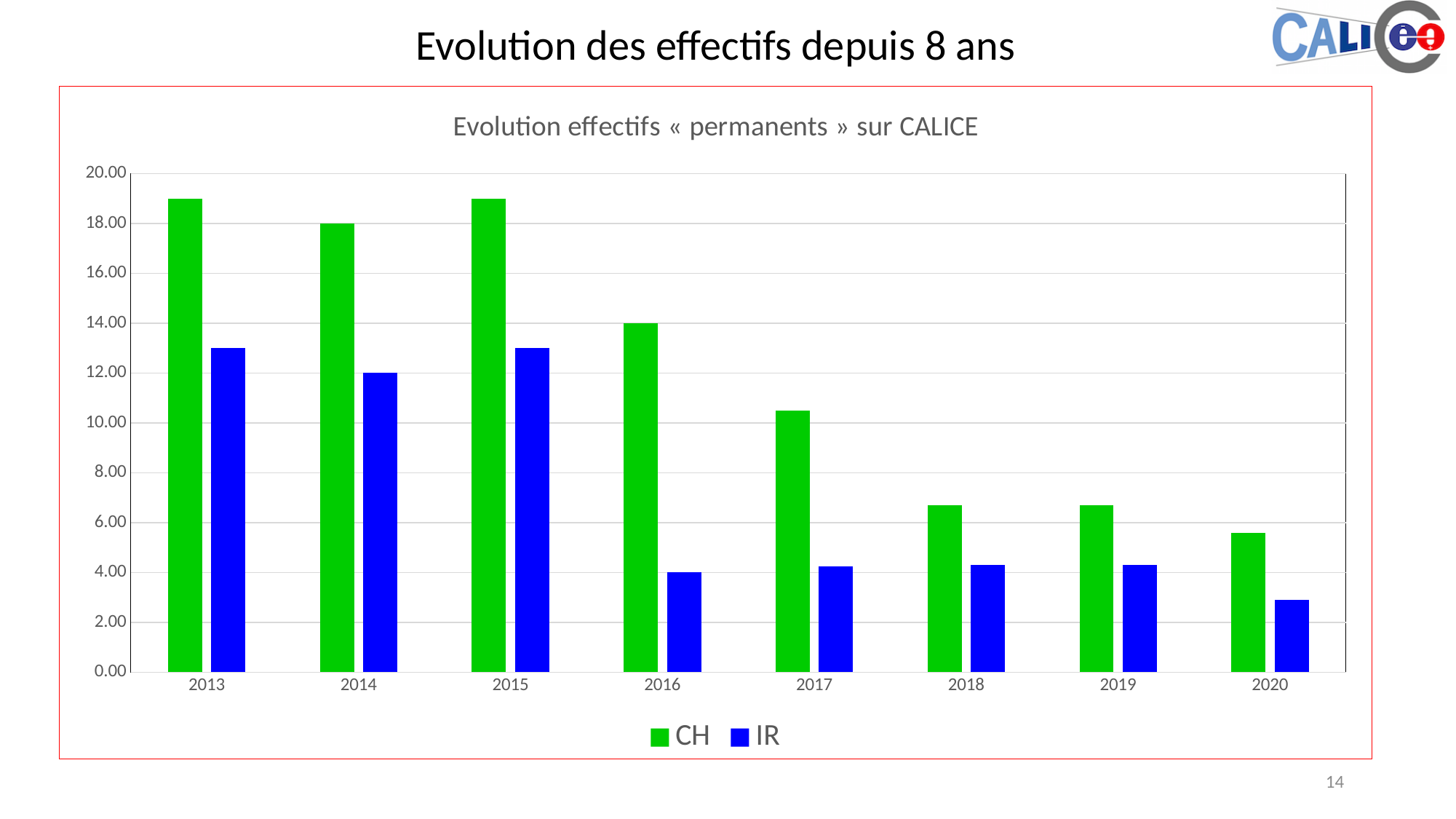
What is the CH value for 2014? 18.00 Is the CH value for 2017 greater or less than 10.00? greater What is the CH value for 2016? 14.00 What is the IR value for 2016? 4.00 Which year has the lowest CH value? 2020 Is the IR value for 2020 greater or less than 4.00? less What kind of chart is shown on the slide? bar chart Do the CH values generally rise or fall from 2013 to 2020? fall How many years are shown on the x axis? 8 How many series does the legend list? 2 What is the IR value for 2014? 12.00 In 2016, which series has the larger value, CH or IR? CH